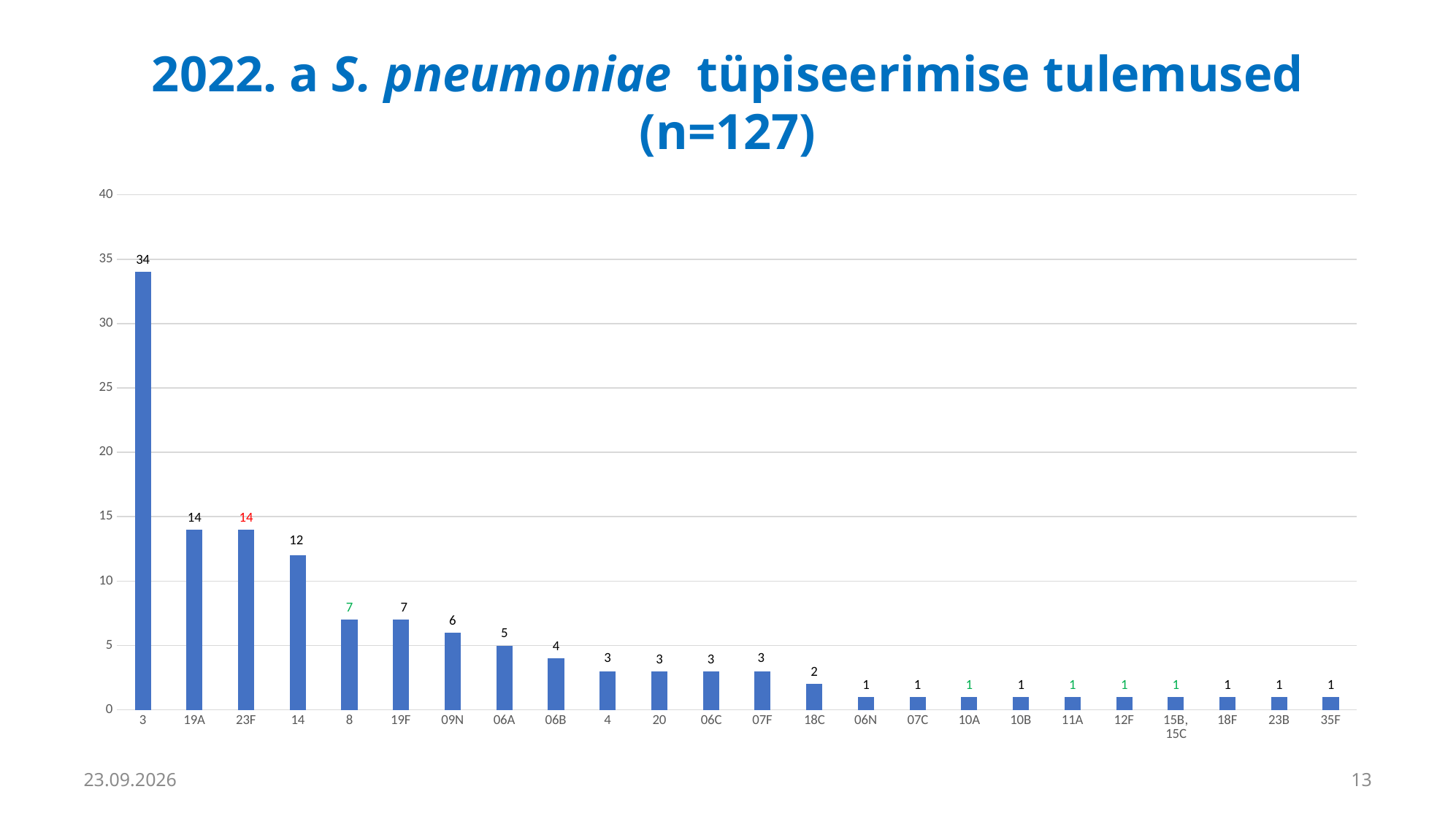
Which is larger, the value for 06B or the value for 07F? 06B What is the value for serotype 19A? 14 How many categories are shown on the x axis? 24 Is the value for serotype 3 greater or less than 30? greater What is the difference between the values for serotype 8 and serotype 06A? 2 What is the value for serotype 09N? 6 Which category has the highest value? 3 What kind of chart is shown on the slide? bar chart What is the title of the chart on the slide? 2022. a S. pneumoniae tüpiseerimise tulemused (n=127) What is the difference between the values for serotype 3 and serotype 14? 22 What is the value for serotype 3? 34 What is the value for serotype 18C? 2